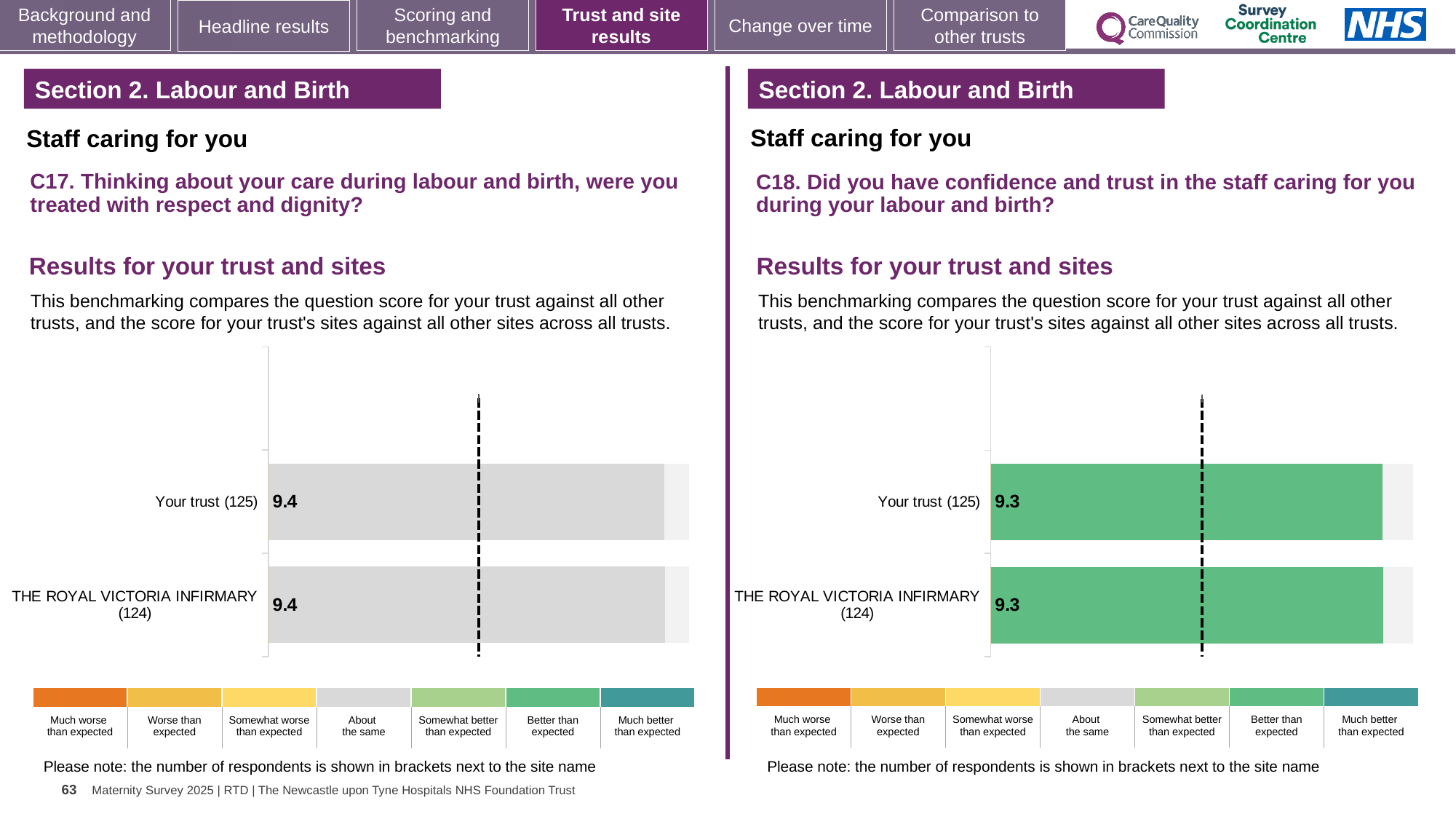
Is the score for Your trust in the C17 chart on the left larger than, smaller than, or equal to the score for Your trust in the C18 chart on the right? Larger In the C17 chart on the left, what is the difference between the score for Your trust and the score for THE ROYAL VICTORIA INFIRMARY? 0.0 In the C18 chart on the right, what is the score for Your trust (125)? 9.3 How many bars are plotted in the C17 chart on the left? 2 In the C18 chart on the right, what is the score for THE ROYAL VICTORIA INFIRMARY (124)? 9.3 What kind of chart is used for the C17 results on the left? Bar chart According to the colour key, which benchmarking category do the bars in the C18 chart on the right fall into? Better than expected In the C17 chart on the left, what is the score for THE ROYAL VICTORIA INFIRMARY (124)? 9.4 How many bars are plotted in the C18 chart on the right? 2 In the C18 chart on the right, what is the difference between the score for Your trust and the score for THE ROYAL VICTORIA INFIRMARY? 0.0 In the C17 chart on the left, what is the score for Your trust (125)? 9.4 According to the colour key, which benchmarking category do the bars in the C17 chart on the left fall into? About the same